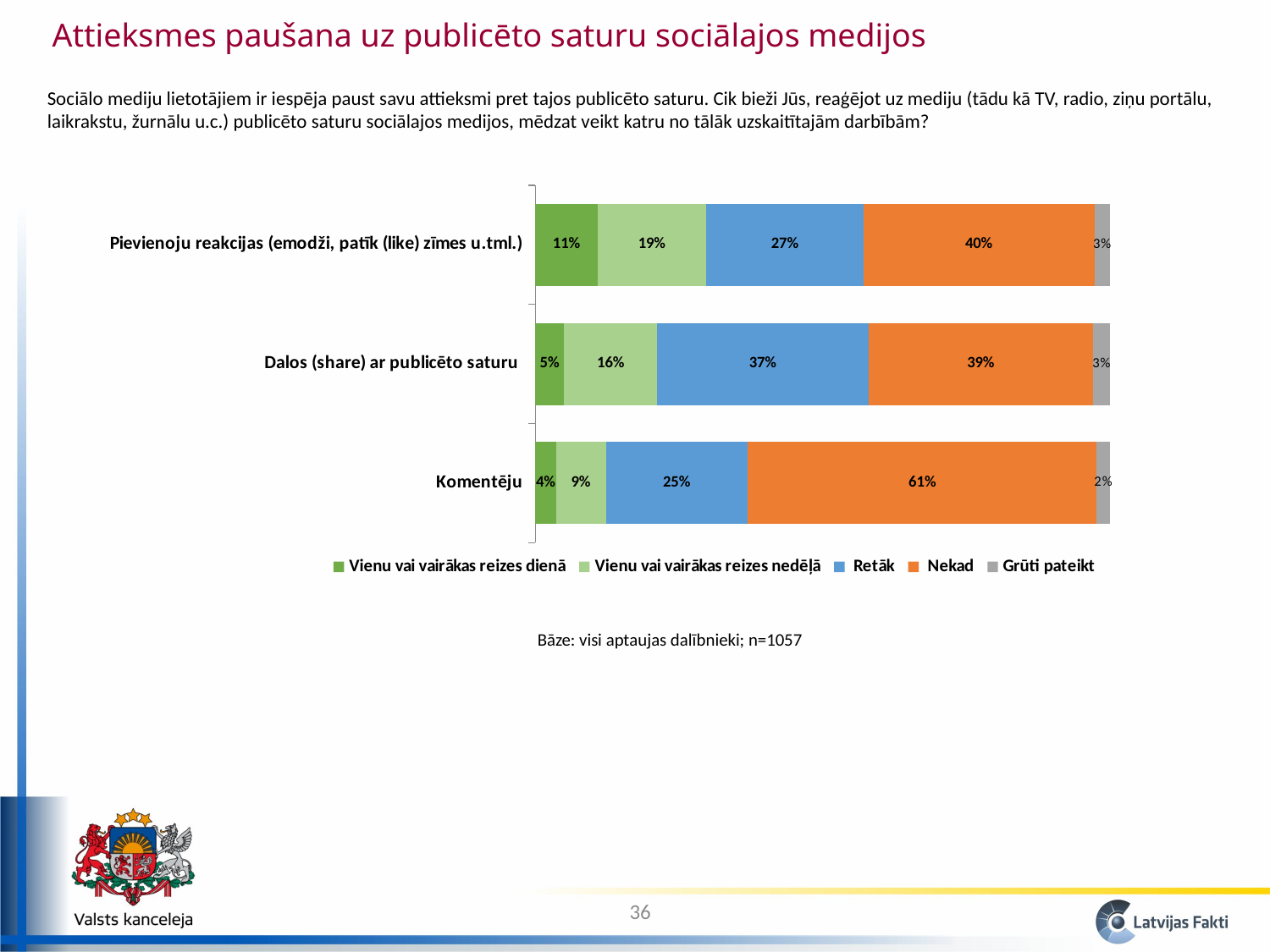
What is the "Grūti pateikt" value for "Komentēju"? 2% What is the "Retāk" value for "Dalos (share) ar publicēto saturu"? 37% How many activities (categories) are shown in the chart? 3 Which activity has the lowest "Vienu vai vairākas reizes dienā" share? Komentēju Which is larger: the "Retāk" value for "Dalos (share) ar publicēto saturu" or for "Pievienoju reakcijas (emodži, patīk (like) zīmes u.tml.)"? Dalos (share) ar publicēto saturu What is the "Vienu vai vairākas reizes dienā" value for "Komentēju"? 4% What is the difference between the "Nekad" values for "Komentēju" and "Pievienoju reakcijas (emodži, patīk (like) zīmes u.tml.)"? 21% What kind of chart is shown on the slide? Stacked bar chart Which activity has the highest "Nekad" share? Komentēju What is the combined share of "Vienu vai vairākas reizes dienā" and "Vienu vai vairākas reizes nedēļā" for "Pievienoju reakcijas (emodži, patīk (like) zīmes u.tml.)"? 30% What percentage of respondents say they never ("Nekad") add reactions ("Pievienoju reakcijas (emodži, patīk (like) zīmes u.tml.)")? 40% How many series does the legend list? 5